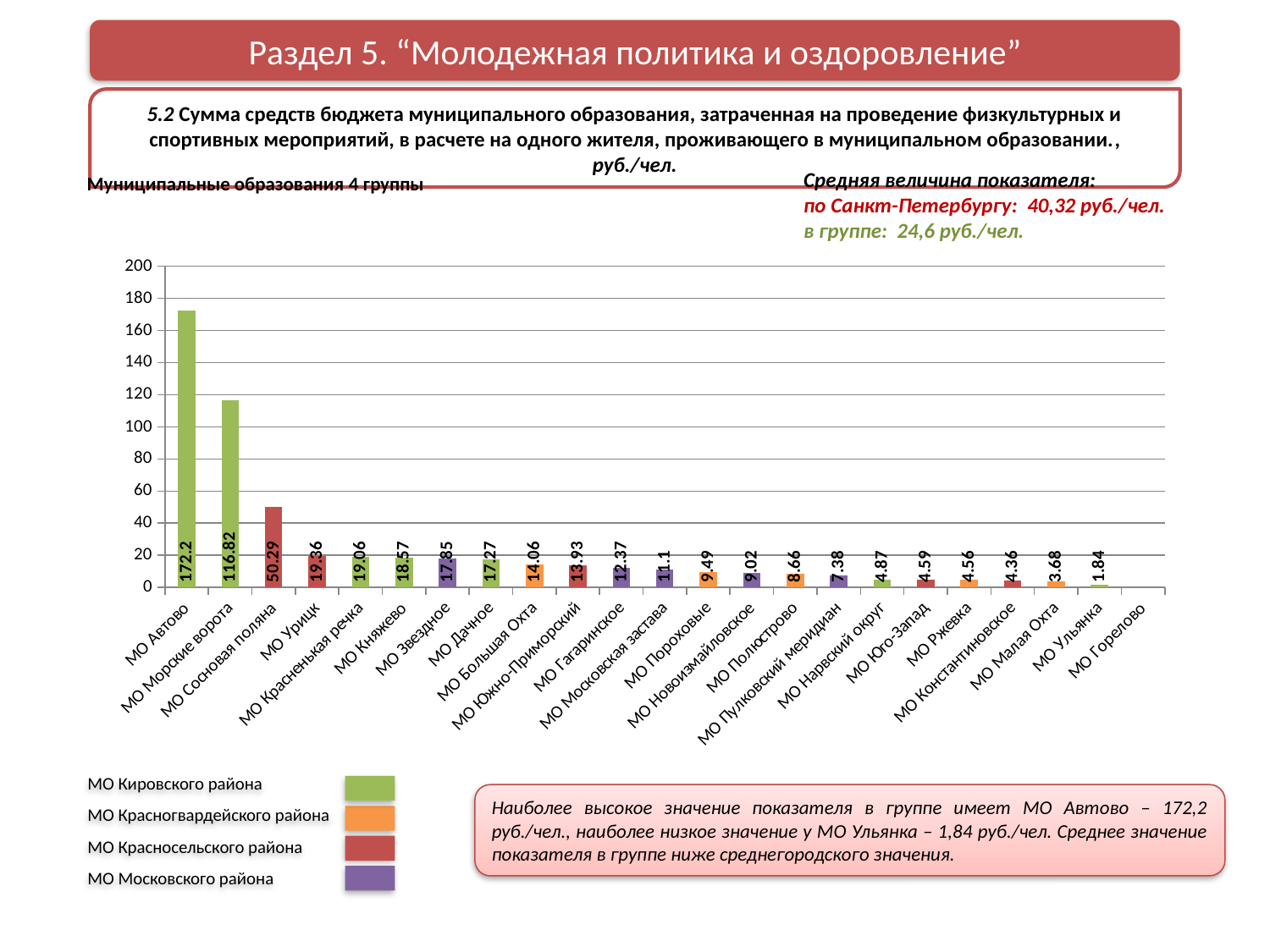
Do the values rise or fall from left to right along the x axis? fall What is the value for МО Пулковский меридиан? 7.38 What is the value for МО Сосновая поляна? 50.29 How many municipalities are listed along the x axis? 23 What is the value for МО Автово? 172.2 What kind of chart is shown on the slide? bar chart Which municipality with a labelled bar has the lowest value on the chart? МО Ульянка Which municipality has the highest value on the chart? МО Автово Is the value for МО Морские ворота greater or less than 100? greater How many district groups are listed in the colour key below the chart? 4 Which is larger, the value for МО Урицк or the value for МО Красненькая речка? МО Урицк What is the difference between the values for МО Автово and МО Морские ворота? 55.38